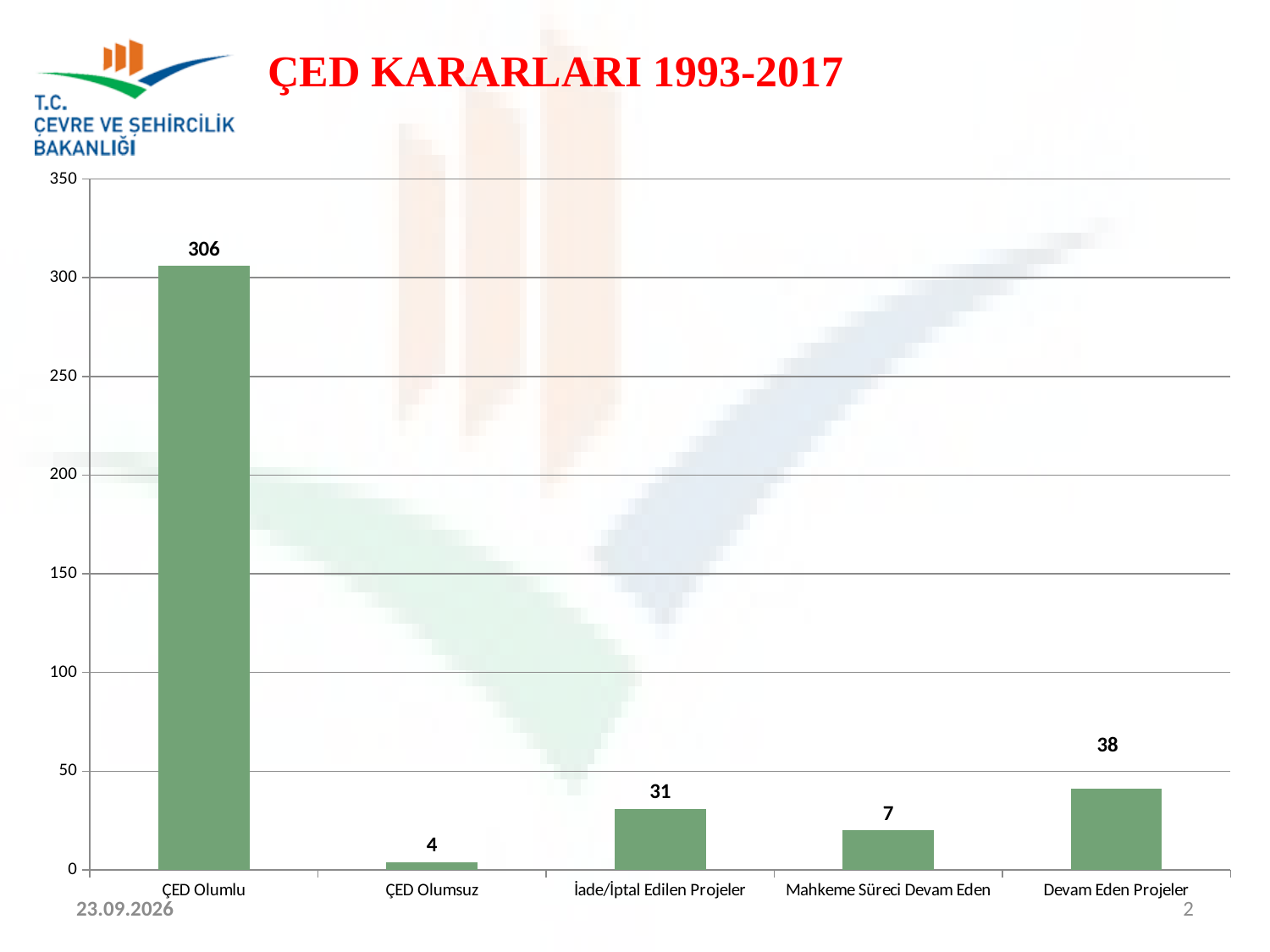
Which category has the highest value? ÇED Olumlu What is the difference between the values for ÇED Olumlu and Devam Eden Projeler? 268 What is the value for İade/İptal Edilen Projeler? 31 What is the value for ÇED Olumsuz? 4 Which is larger, the value for İade/İptal Edilen Projeler or the value for Devam Eden Projeler? Devam Eden Projeler Is the value for ÇED Olumlu greater or less than 300? greater What is the value for Devam Eden Projeler? 38 Which category has the lowest value? ÇED Olumsuz What is the value for ÇED Olumlu? 306 What is the value for Mahkeme Süreci Devam Eden? 7 How many categories are shown on the x axis? 5 What kind of chart is shown on the slide? bar chart